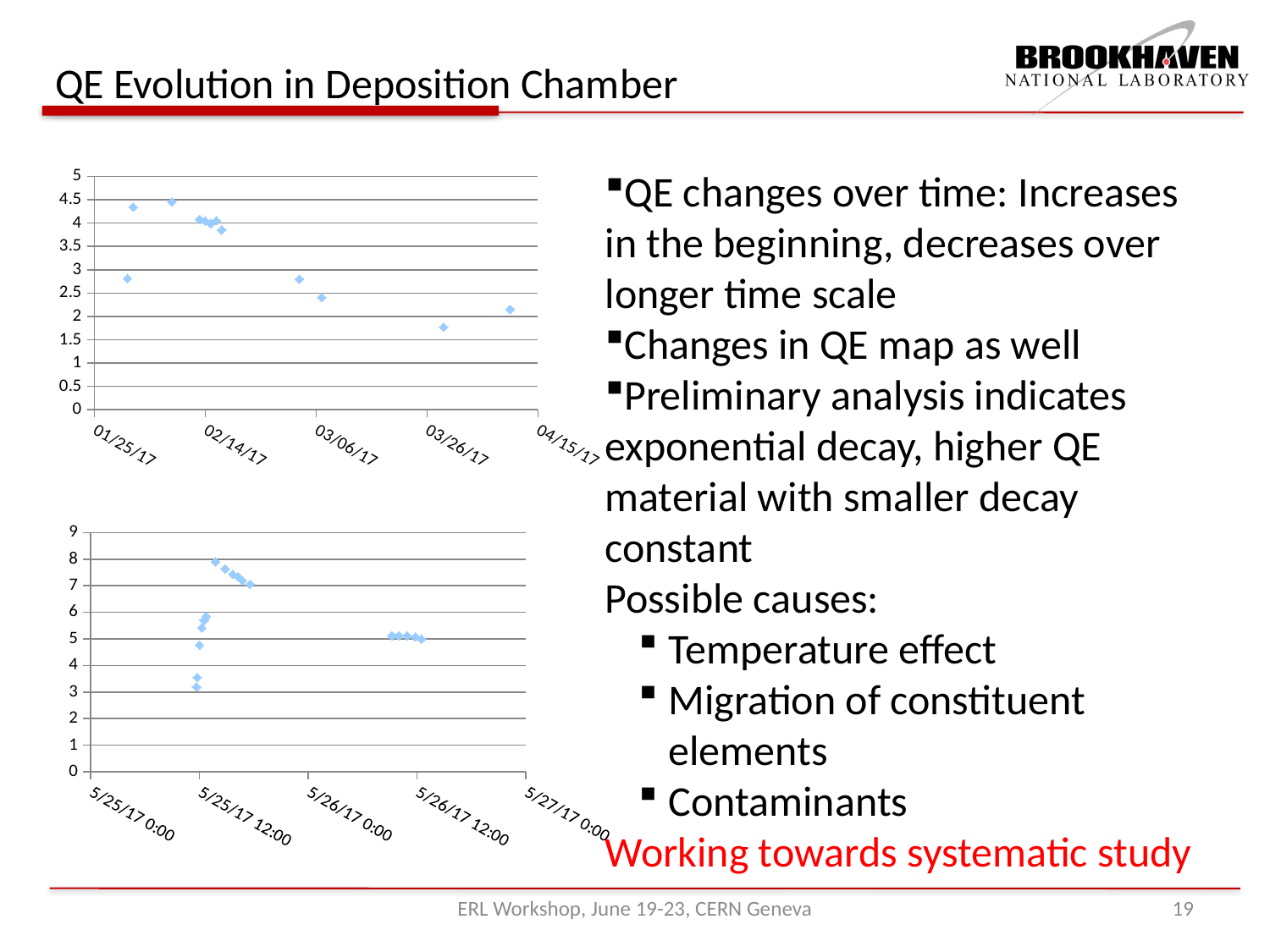
In the bottom chart, is the highest plotted point greater or less than 7? greater In the top chart, what is the highest value shown on the vertical axis? 5 In the top chart, do the plotted values generally rise or fall from 02/14/17 to 03/26/17? fall In the bottom chart, what is the highest value shown on the vertical axis? 9 What kind of chart is the bottom chart on the slide? scatter chart In the top chart, is the value of the last point (near 04/15/17) greater or less than 2? greater In the top chart, is the value of the point near 03/26/17 greater or less than 2? less In the bottom chart, do the plotted values rise or fall between the cluster near 5/25/17 12:00 and the cluster near 5/26/17 12:00? fall What kind of chart is the top chart on the slide? scatter chart In the top chart, how many date labels are shown along the horizontal axis? 5